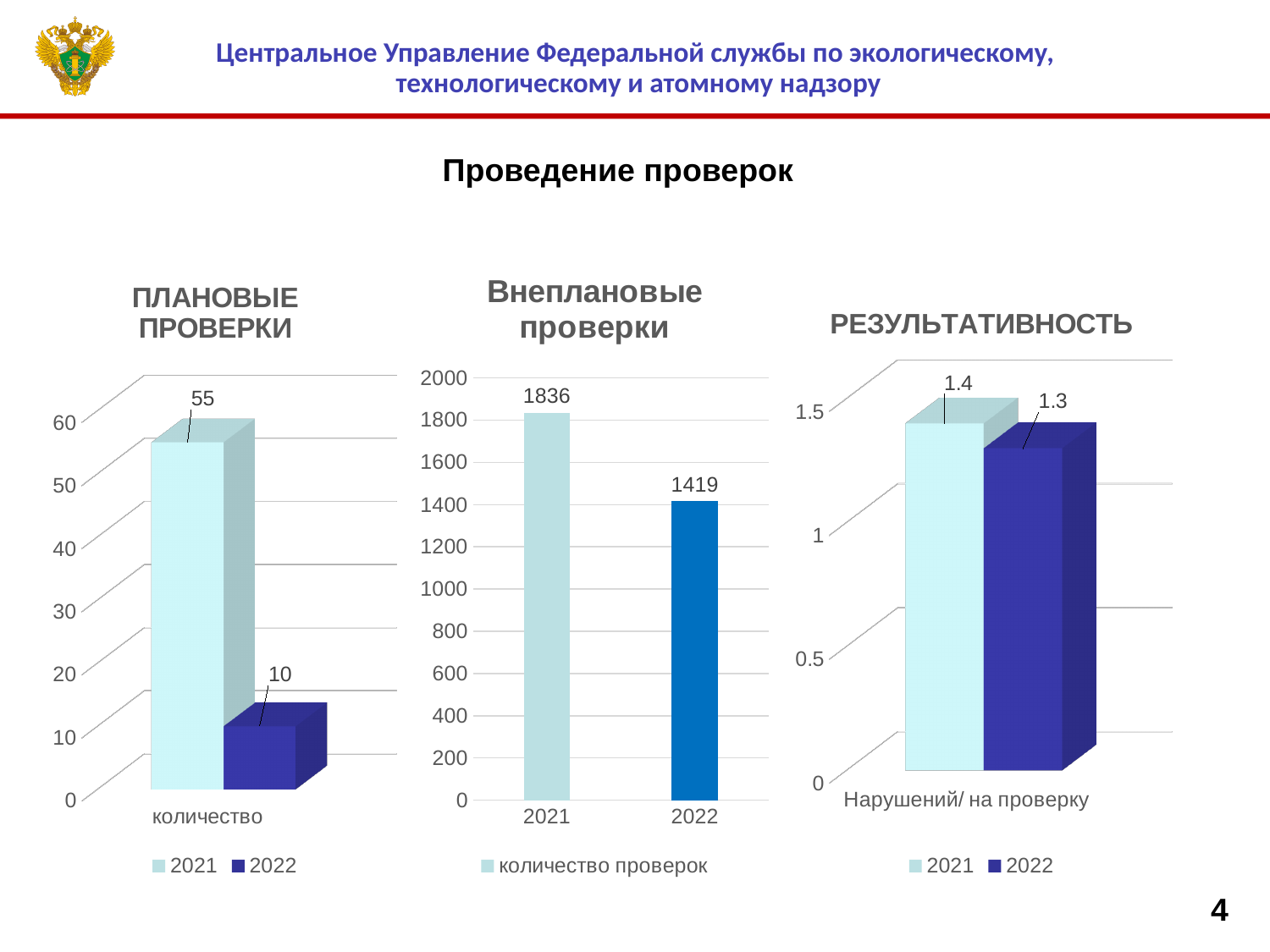
What kind of chart is the 'Внеплановые проверки' chart? Bar chart In the 'ПЛАНОВЫЕ ПРОВЕРКИ' chart, what is the value for 2022? 10 In the 'Внеплановые проверки' chart, what is the legend entry? количество проверок In the 'ПЛАНОВЫЕ ПРОВЕРКИ' chart, what is the value for 2021? 55 In the 'ПЛАНОВЫЕ ПРОВЕРКИ' chart, what is the difference between the 2021 and 2022 values? 45 In the 'Внеплановые проверки' chart, what is the value for 2021? 1836 In the 'РЕЗУЛЬТАТИВНОСТЬ' chart, what is the value for 2021? 1.4 In the 'Внеплановые проверки' chart, what is the difference between the 2021 and 2022 values? 417 In the 'Внеплановые проверки' chart, what is the value for 2022? 1419 In the 'РЕЗУЛЬТАТИВНОСТЬ' chart, how many series does the legend list? 2 In the 'РЕЗУЛЬТАТИВНОСТЬ' chart, what is the value for 2022? 1.3 In the 'Внеплановые проверки' chart, which year has the higher value? 2021